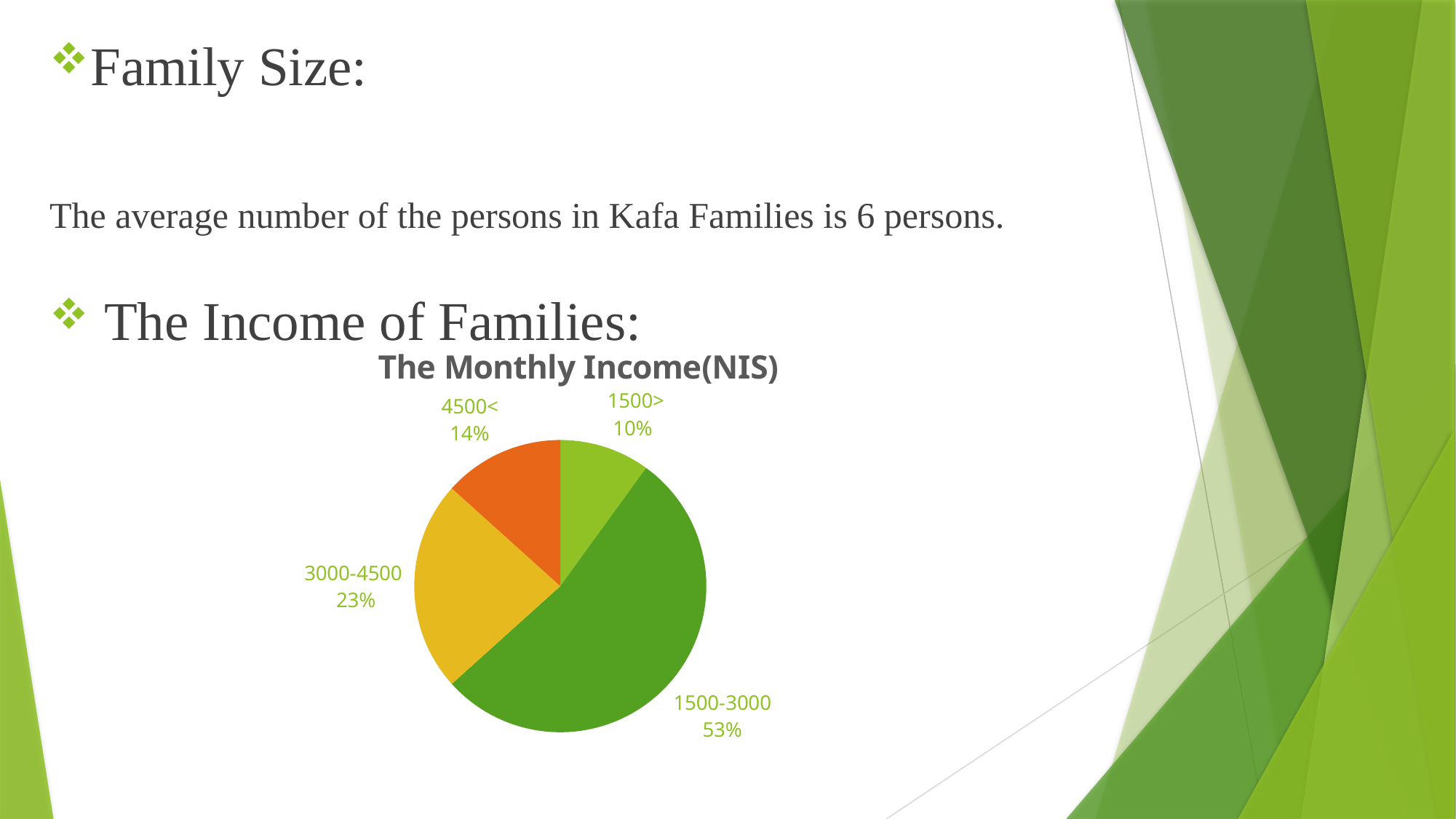
What colour is the 3000-4500 slice? yellow What share of the pie does the 3000-4500 slice represent? 23% Which slice is larger, 4500< or 1500>? 4500< What kind of chart is shown on the slide? pie chart Which income category has the largest share of the pie? 1500-3000 What share of the pie does the 1500-3000 slice represent? 53% What is the difference in percentage points between the 1500-3000 slice and the 3000-4500 slice? 30 Which income category has the smallest share of the pie? 1500> What is the title of the chart? The Monthly Income(NIS) How many slices does the pie chart have? 4 What share of the pie does the 1500> slice represent? 10%